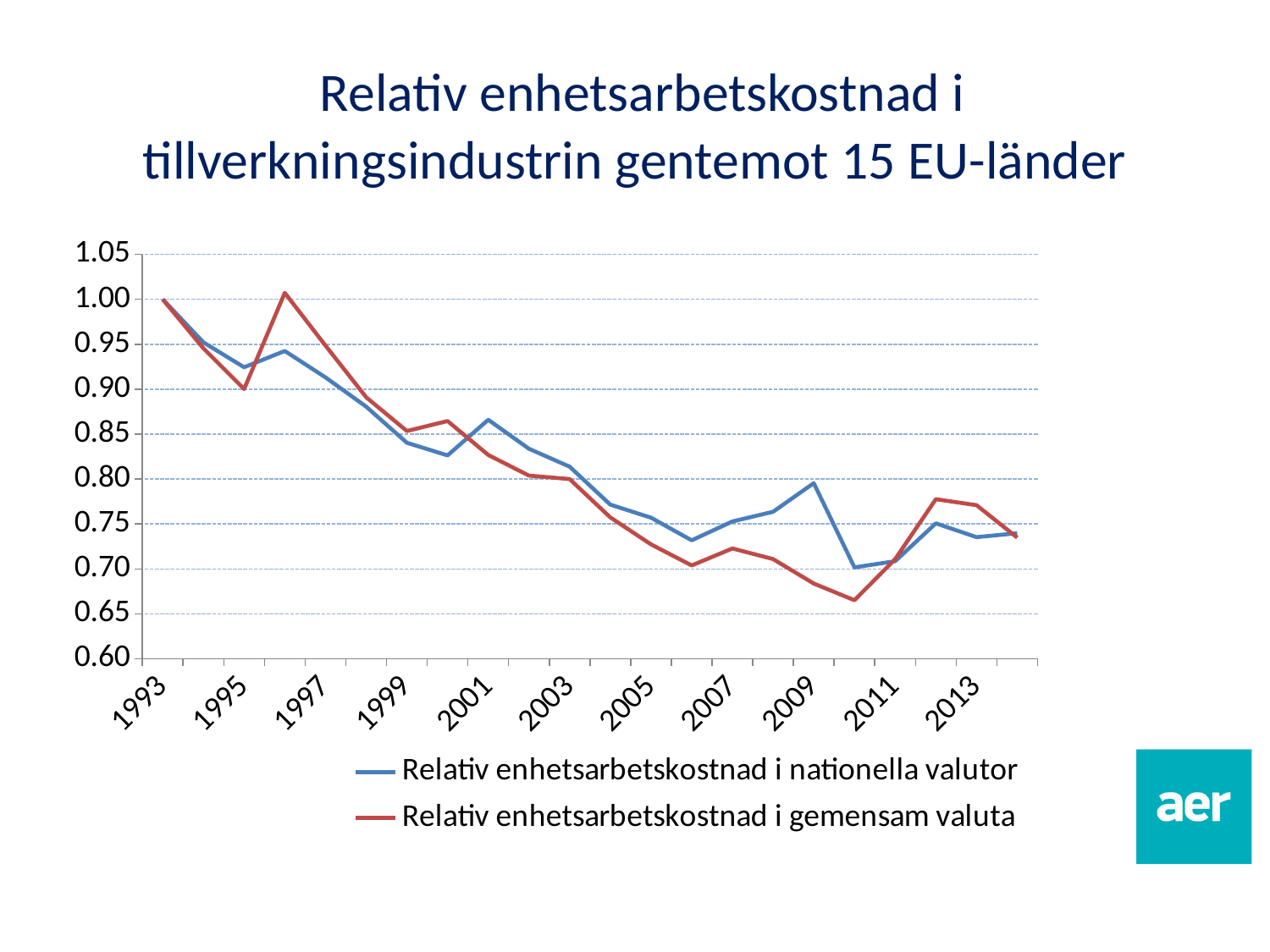
In 1997, which series has the higher value? Relativ enhetsarbetskostnad i gemensam valuta Do the values of 'Relativ enhetsarbetskostnad i nationella valutor' generally rise or fall from 1993 to the end of the series? fall What is the value of 'Relativ enhetsarbetskostnad i gemensam valuta' in 1993? 1.00 What is the value of 'Relativ enhetsarbetskostnad i nationella valutor' in 1993? 1.00 What is the title of the chart? Relativ enhetsarbetskostnad i tillverkningsindustrin gentemot 15 EU-länder Is the value for 'Relativ enhetsarbetskostnad i gemensam valuta' in 2009 greater or less than 0.70? less Which series is drawn in red according to the legend? Relativ enhetsarbetskostnad i gemensam valuta How many series does the legend list? 2 What kind of chart is shown on the slide? line chart In 2009, which series has the higher value? Relativ enhetsarbetskostnad i nationella valutor Is the value for 'Relativ enhetsarbetskostnad i nationella valutor' in 2009 greater or less than 0.75? greater